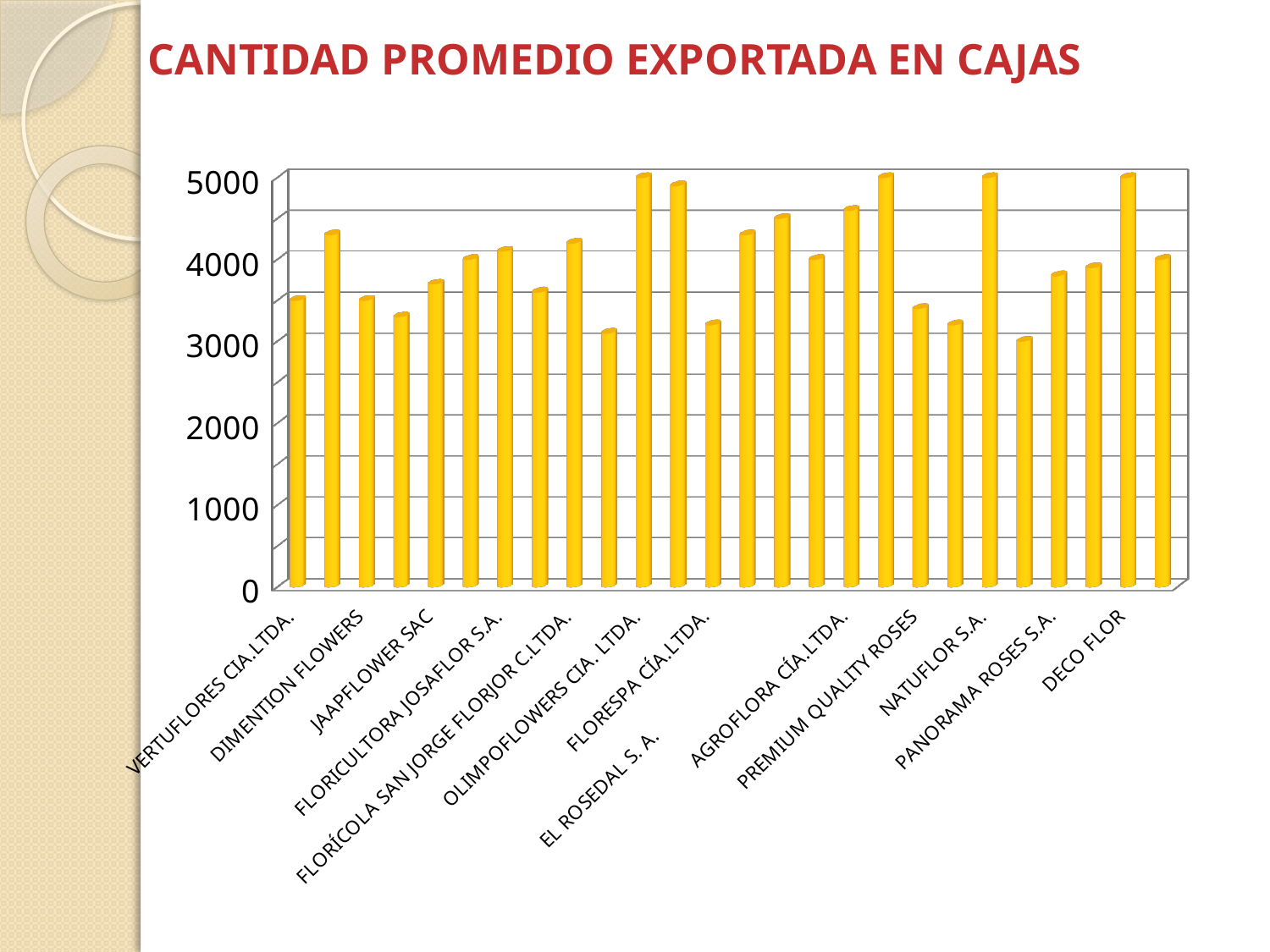
Which is larger, the value for EL ROSEDAL S.A. or the value for PREMIUM QUALITY ROSES? EL ROSEDAL S.A. Is the value for EL ROSEDAL S.A. greater or less than 4000? greater Is the value for VERTUFLORES CIA.LTDA. greater or less than 3000? greater What is the title of the chart? CANTIDAD PROMEDIO EXPORTADA EN CAJAS Is the value for FLORESPA CÍA.LTDA. greater or less than 4000? less Which is larger, the value for OLIMPOFLOWERS CIA. LTDA. or the value for FLORESPA CÍA.LTDA.? OLIMPOFLOWERS CIA. LTDA. What kind of chart is shown on the slide? bar chart What is the highest value shown on the vertical axis? 5000